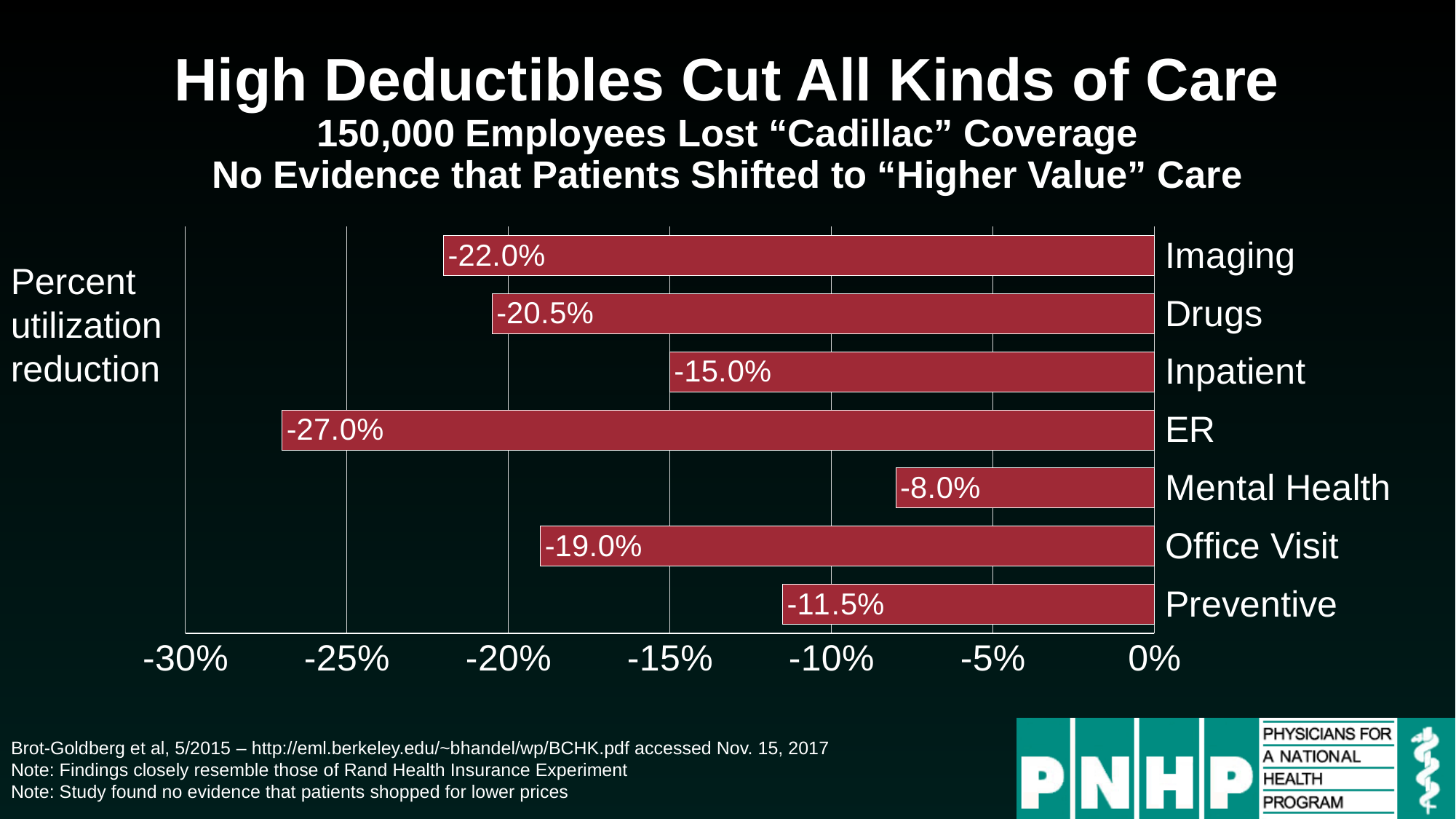
Which category shows the largest utilization reduction? ER Which has a larger utilization reduction, Drugs or Office Visit? Drugs By how many percentage points does the ER reduction exceed the Mental Health reduction? 19.0 percentage points What is the percent utilization reduction for Imaging? -22.0% What is the percent utilization reduction for Office Visit? -19.0% What is the percent utilization reduction for Drugs? -20.5% What is the percent utilization reduction for Preventive care? -11.5% How many categories of care are shown in the chart? 7 What kind of chart is shown on the slide? Bar chart Which category shows the smallest utilization reduction? Mental Health What is the label on the left side of the chart describing what the bars measure? Percent utilization reduction What is the difference in percentage points between the Imaging and Inpatient reductions? 7.0 percentage points